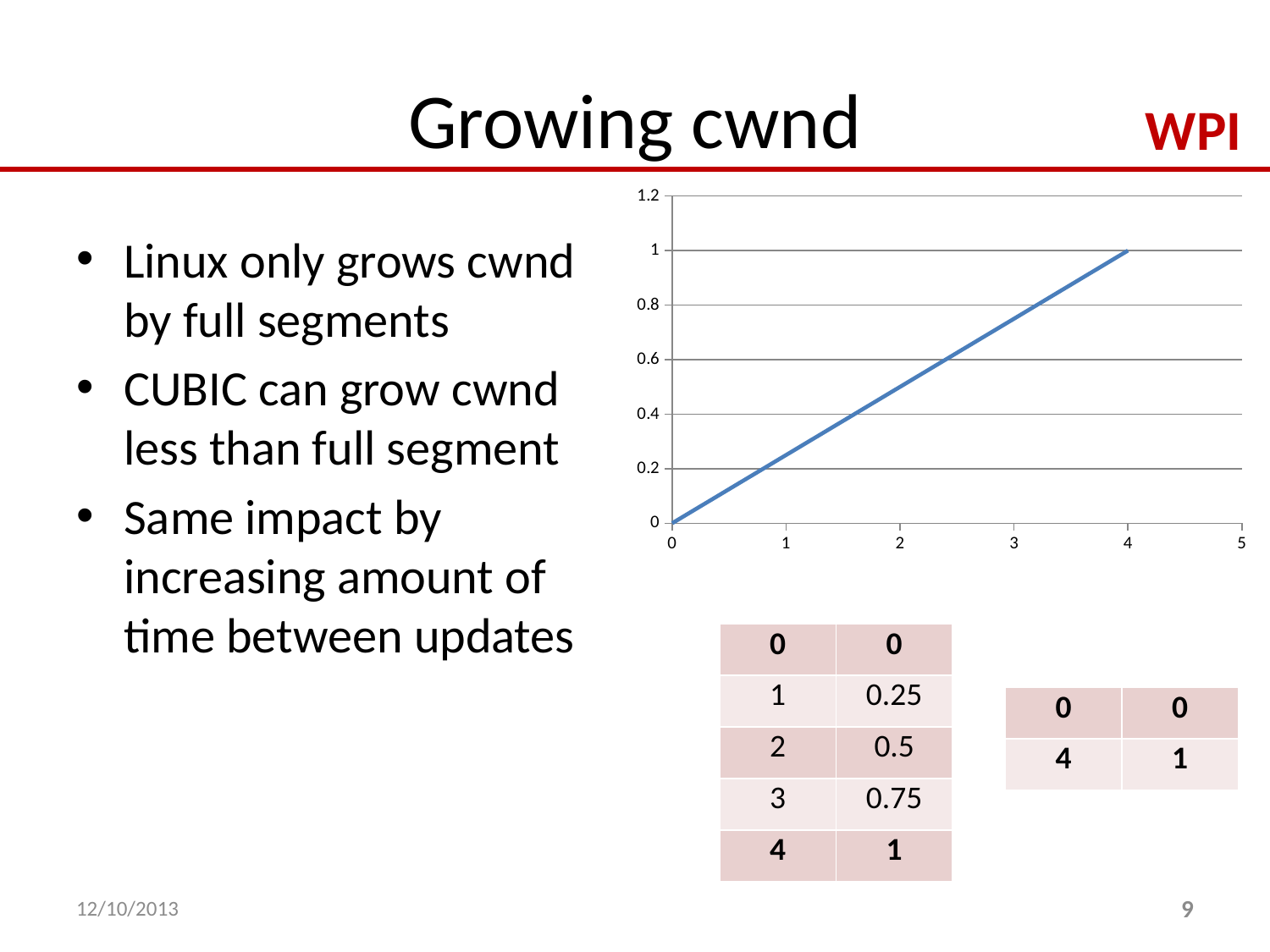
What is the y value of the line at x = 0? 0 Does the line on the chart rise or fall as x increases from 0 to 4? rise Is the value of the line at x = 1 greater or less than 0.4? less At which x value is the line at its lowest point? 0 Which is larger, the value of the line at x = 3 or at x = 1? x = 3 Is the value of the line at x = 4 greater or less than 1.2? less Is the value of the line at x = 2 greater or less than 0.4? greater At which x value does the line reach its highest point? 4 What is the y value of the line at x = 4? 1 What kind of chart is shown on the slide? line chart What is the highest tick label shown on the y axis of the chart? 1.2